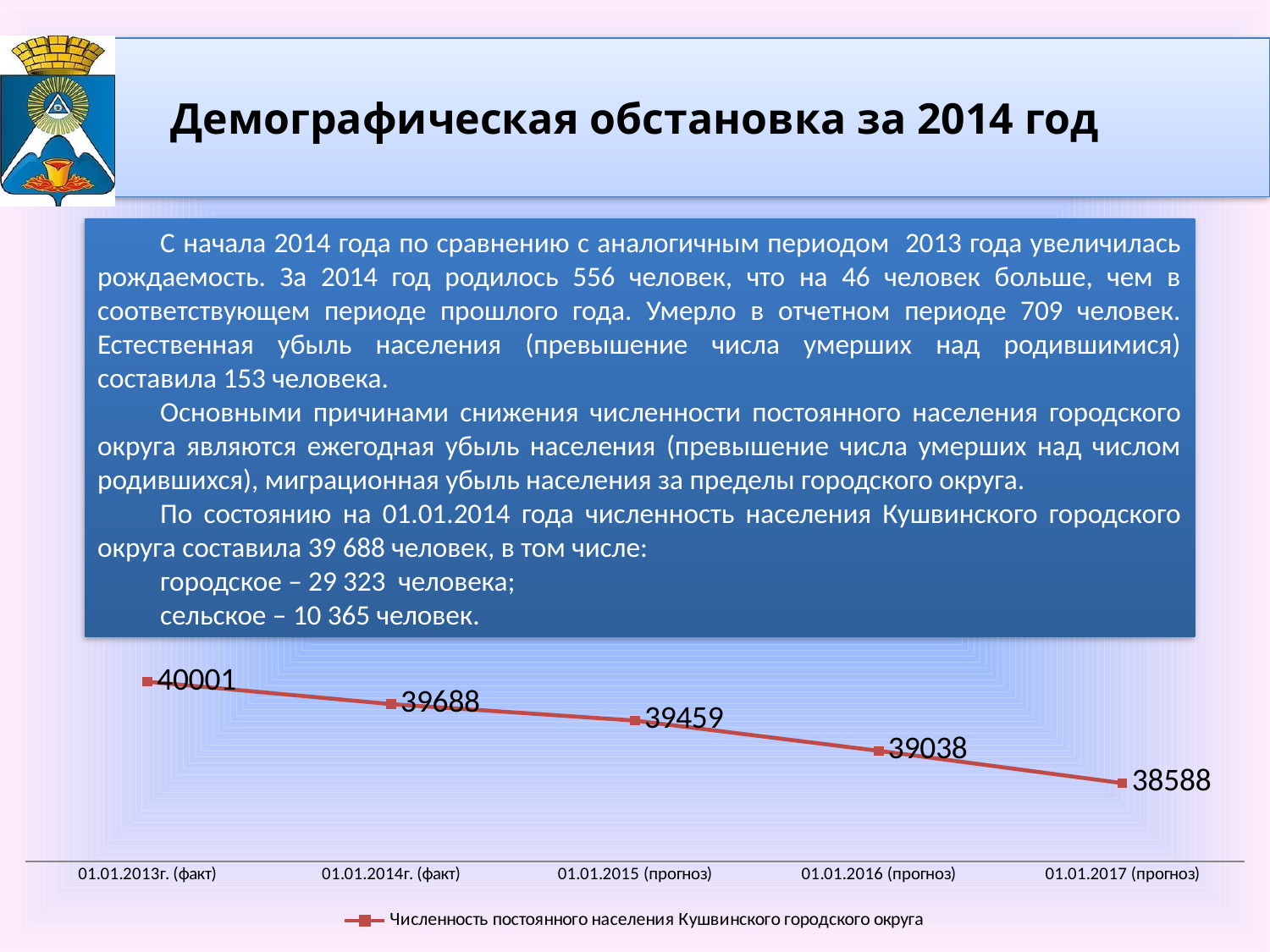
Which date has the lowest value? 01.01.2017 (прогноз) What is the value for 01.01.2013г. (факт)? 40001 What is the difference between the values for 01.01.2013г. (факт) and 01.01.2014г. (факт)? 313 What is the value for 01.01.2014г. (факт)? 39688 Which date has the highest value? 01.01.2013г. (факт) What is the difference between the values for 01.01.2016 (прогноз) and 01.01.2017 (прогноз)? 450 How many data points are plotted on the chart? 5 Which is larger, the value for 01.01.2015 (прогноз) or 01.01.2016 (прогноз)? 01.01.2015 (прогноз) What kind of chart is shown on the slide? line chart Do the values rise or fall along the x axis? fall What is the value for 01.01.2017 (прогноз)? 38588 What is the value for 01.01.2015 (прогноз)? 39459